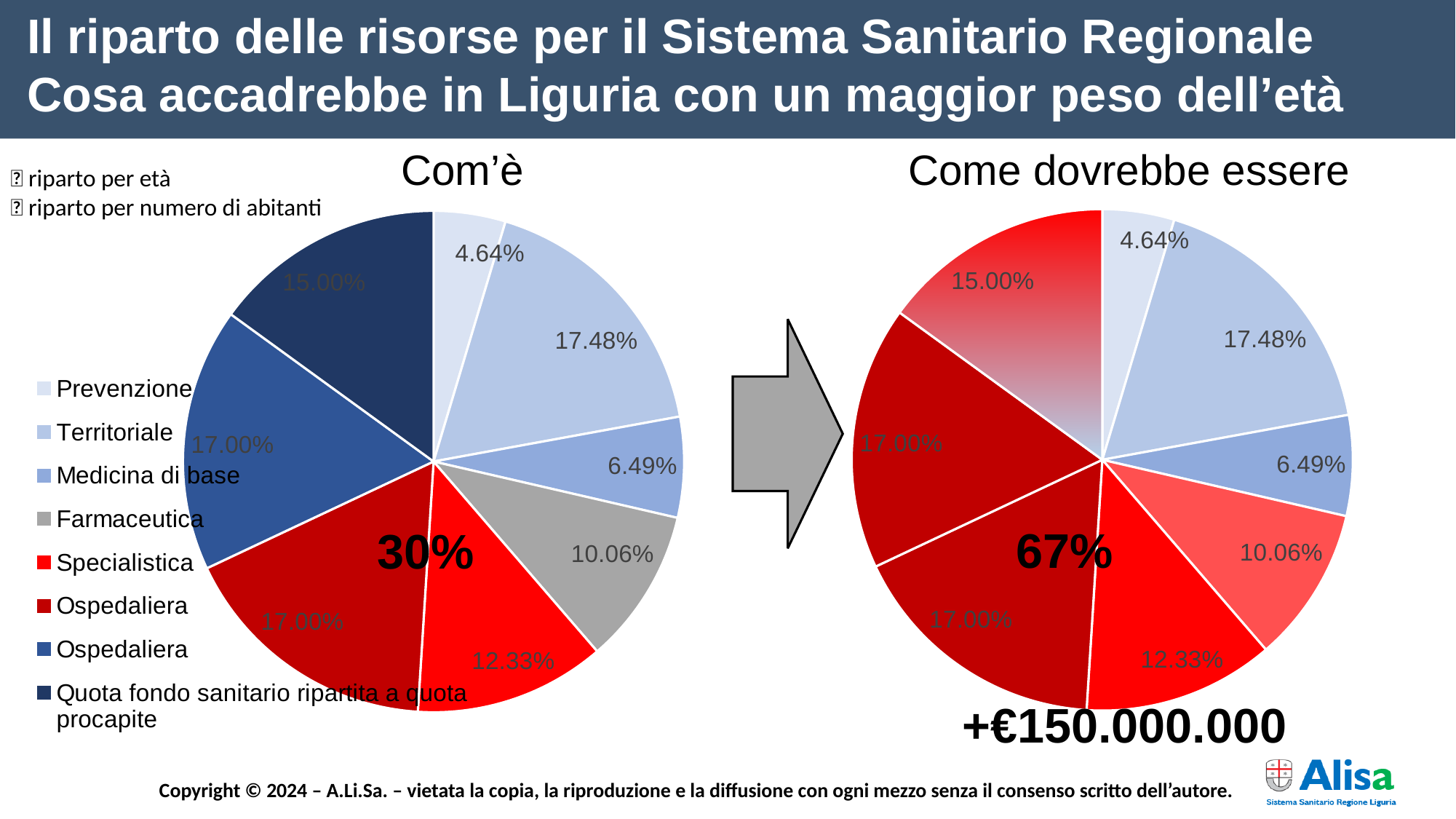
In the "Com'è" chart, what is the value for Prevenzione? 4.64% In the "Com'è" chart, what is the value for Territoriale? 17.48% In the "Com'è" chart, which category has the smallest share? Prevenzione In the "Come dovrebbe essere" chart, what is the value for Specialistica? 12.33% What kind of chart is used on this slide? pie chart In the "Com'è" chart, what is the value for Quota fondo sanitario ripartita a quota procapite? 15.00% In the "Com'è" chart, what is the difference between the Territoriale and Medicina di base values? 10.99% In the "Com'è" chart, which category has the largest share? Territoriale How many slices does the "Com'è" pie chart have? 8 In the "Com'è" chart, what is the value for Farmaceutica? 10.06% In the "Come dovrebbe essere" chart, which is larger, Farmaceutica or Specialistica? Specialistica In the "Come dovrebbe essere" chart, what is the value for Medicina di base? 6.49%